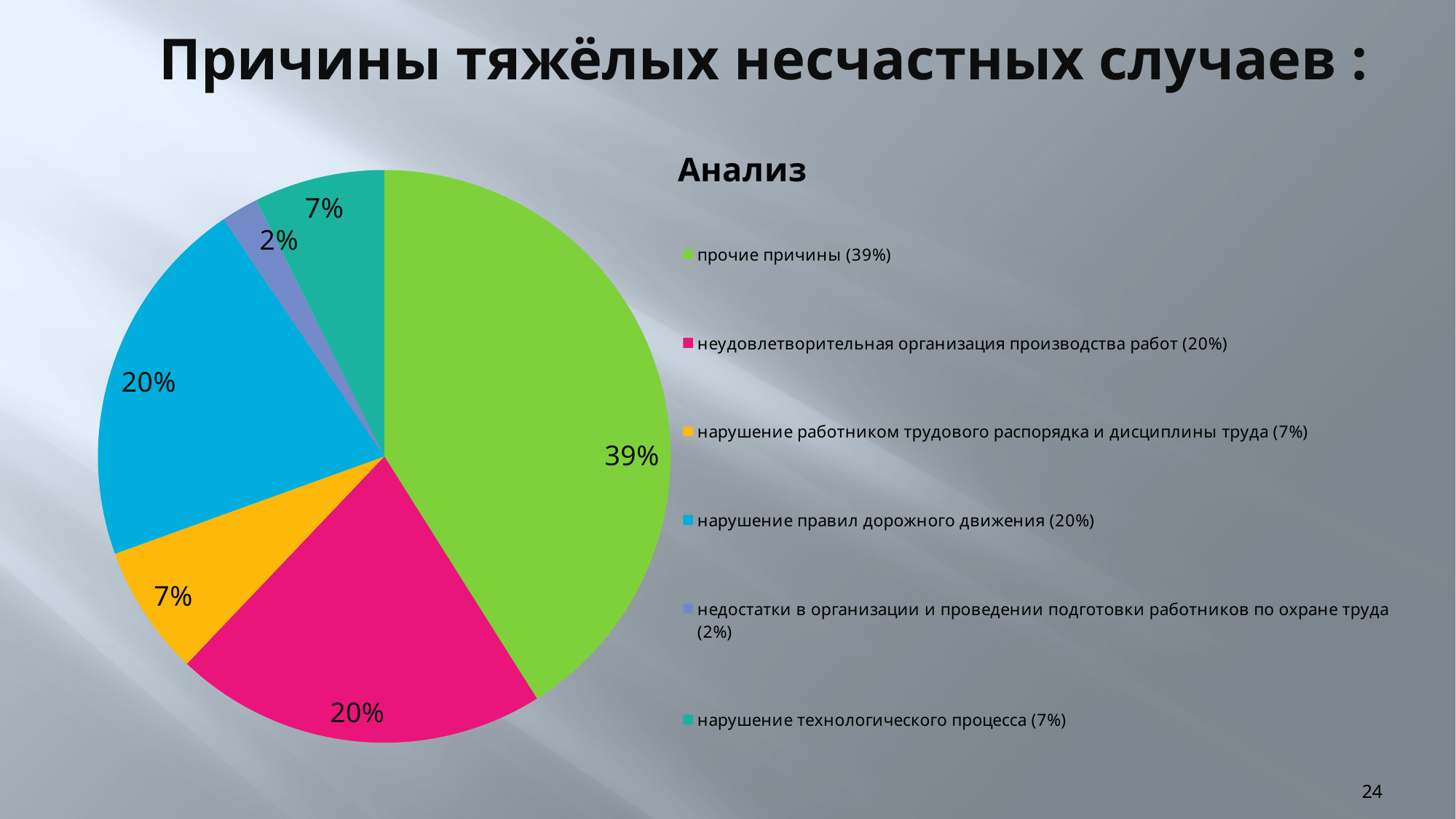
What is the chart's title? Анализ Which category has the largest share of the pie? прочие причины What is the value for 'нарушение правил дорожного движения'? 20% What is the value for 'нарушение технологического процесса'? 7% Which is larger: 'прочие причины' or 'неудовлетворительная организация производства работ'? прочие причины What is the value for 'недостатки в организации и проведении подготовки работников по охране труда'? 2% How many categories does the pie chart have? 6 What share of the pie is 'прочие причины'? 39% What type of chart is shown on the slide? pie chart What colour is the slice for 'нарушение работником трудового распорядка и дисциплины труда'? yellow What is the difference in percentage points between 'прочие причины' and 'неудовлетворительная организация производства работ'? 19 Which category has the smallest share of the pie? недостатки в организации и проведении подготовки работников по охране труда